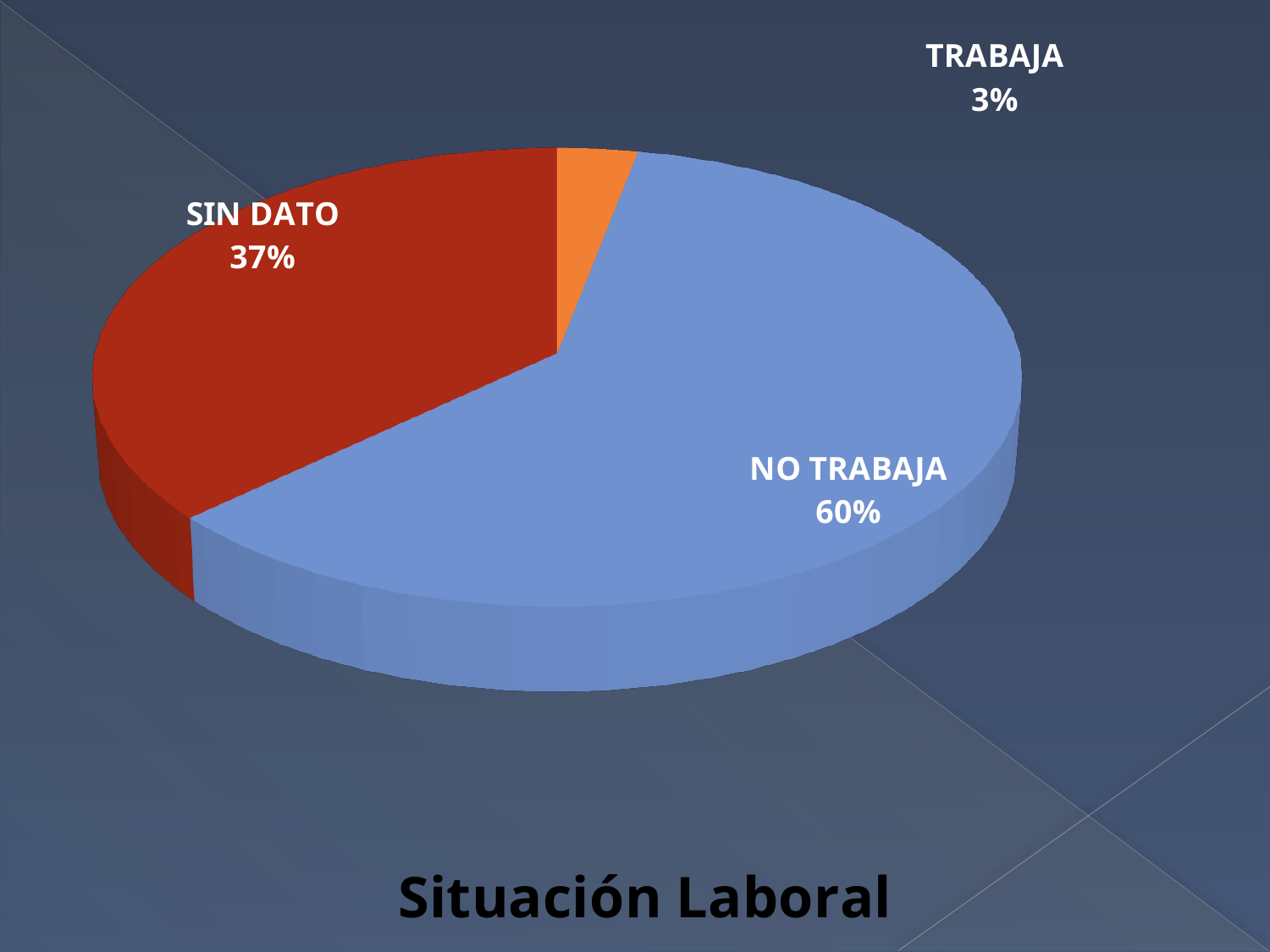
Which category has the smallest share of the pie? TRABAJA What percentage of the pie is labelled TRABAJA? 3% What percentage of the pie is labelled SIN DATO? 37% What is the difference in percentage points between NO TRABAJA and SIN DATO? 23 Which category has the largest share of the pie? NO TRABAJA Which is larger, the share for SIN DATO or the share for TRABAJA? SIN DATO How many slices does the pie chart have? 3 What is the title of the chart? Situación Laboral What percentage of the pie is labelled NO TRABAJA? 60% What kind of chart is shown on the slide? Pie chart What colour is the NO TRABAJA slice? Blue What is the difference in percentage points between SIN DATO and TRABAJA? 34